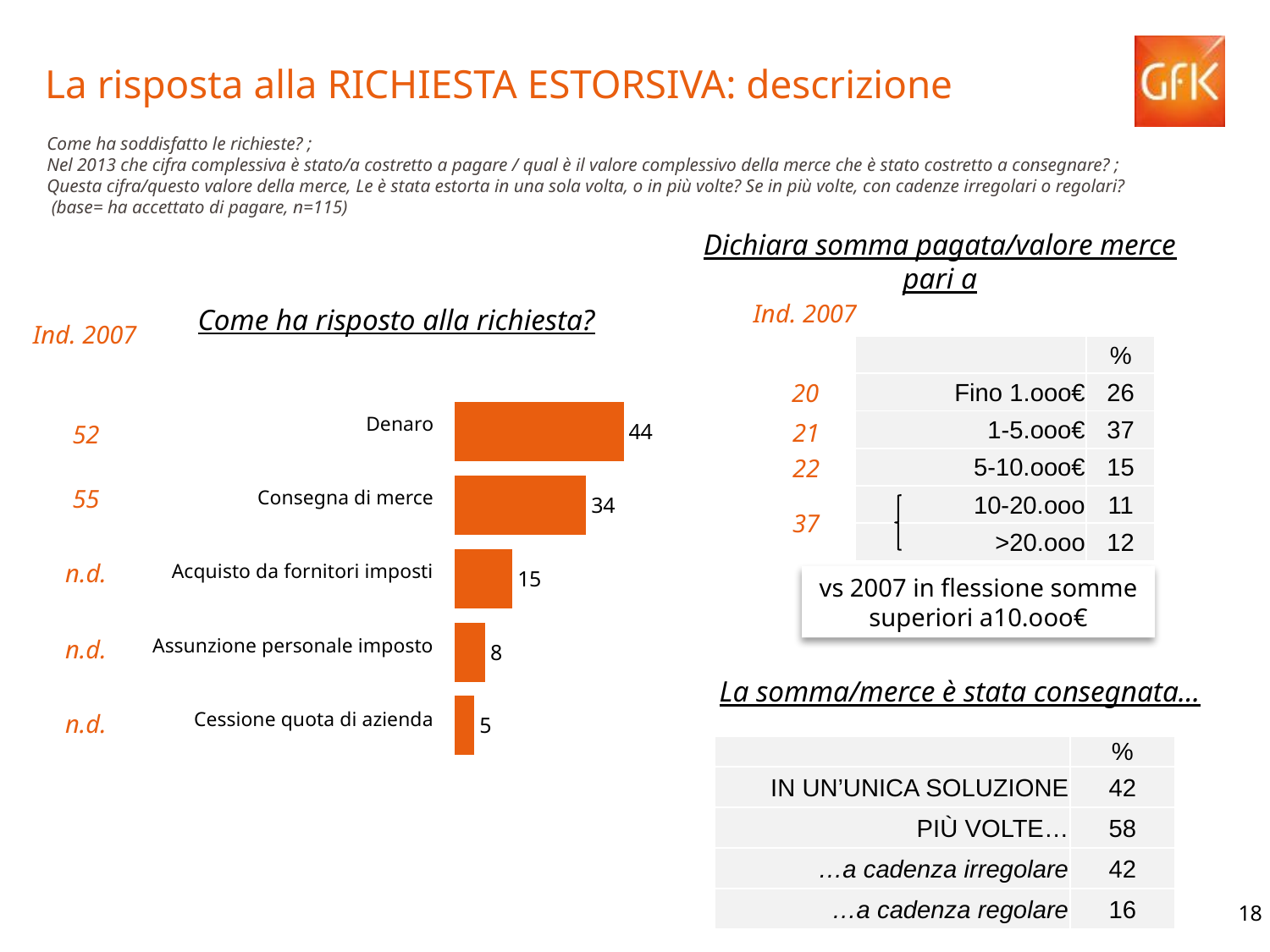
In the chart "Come ha risposto alla richiesta?", what is the difference between the values for Denaro and Consegna di merce? 10 In the chart "Come ha risposto alla richiesta?", what is the Ind. 2007 value shown next to Consegna di merce? 55 In the chart "Come ha risposto alla richiesta?", what is the difference between the values for Acquisto da fornitori imposti and Assunzione personale imposto? 7 In the chart "Come ha risposto alla richiesta?", which category has the lowest value? Cessione quota di azienda In the chart "Come ha risposto alla richiesta?", what is the value for Acquisto da fornitori imposti? 15 What kind of chart is "Come ha risposto alla richiesta?"? Bar chart In the chart "Come ha risposto alla richiesta?", what is the value for Consegna di merce? 34 How many categories are shown in the chart "Come ha risposto alla richiesta?"? 5 In the chart "Come ha risposto alla richiesta?", which category has the highest value? Denaro In the chart "Come ha risposto alla richiesta?", what is the value for Denaro? 44 In the chart "Come ha risposto alla richiesta?", which is larger: Consegna di merce or Acquisto da fornitori imposti? Consegna di merce In the chart "Come ha risposto alla richiesta?", what is the value for Cessione quota di azienda? 5